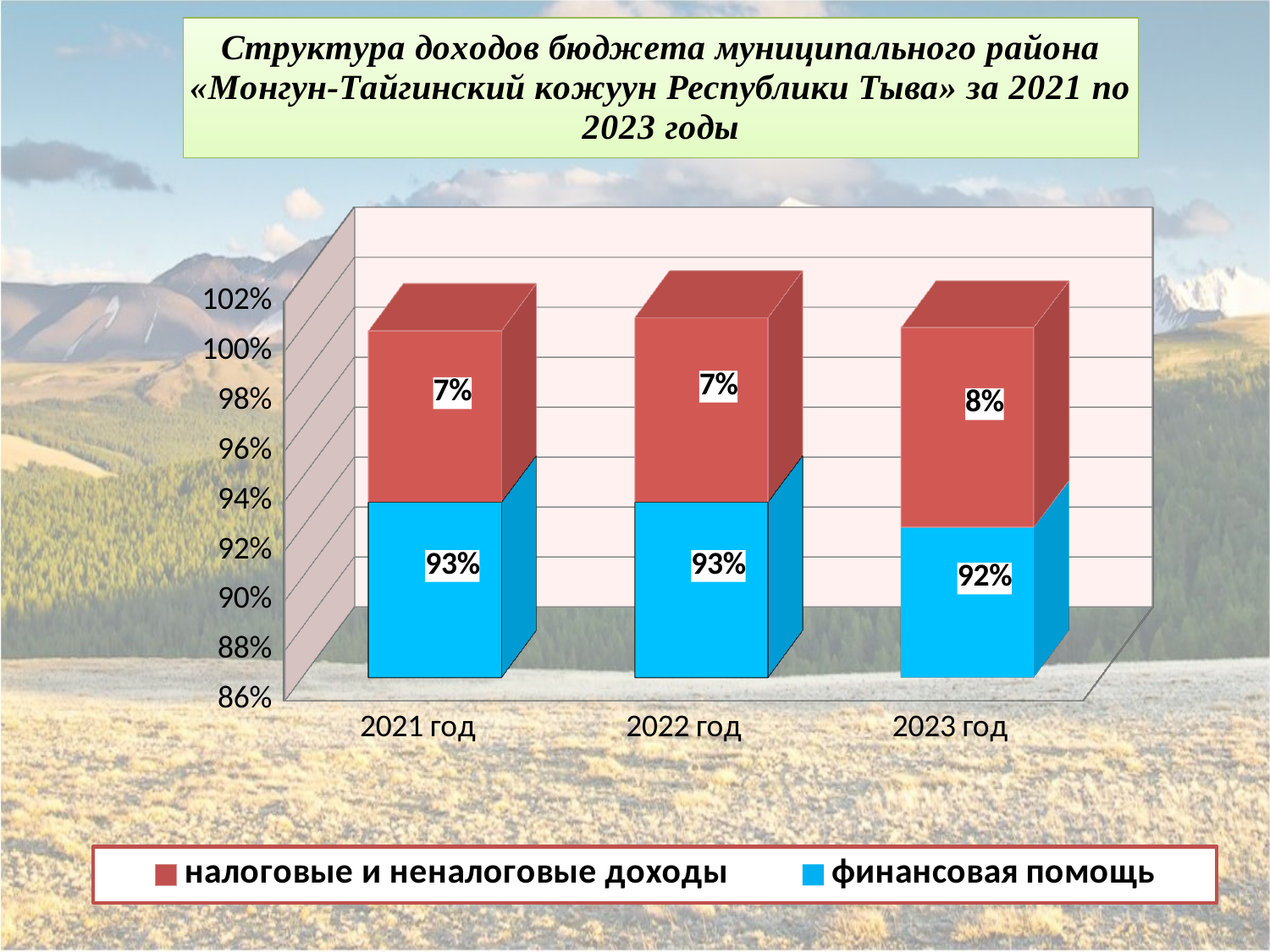
What is the value of налоговые и неналоговые доходы for 2023 год? 8% In which year is the share of финансовая помощь lowest? 2023 год What is the value of налоговые и неналоговые доходы for 2022 год? 7% What is the value of финансовая помощь for 2023 год? 92% In which year is the share of налоговые и неналоговые доходы highest? 2023 год What is the value of финансовая помощь for 2021 год? 93% What kind of chart is shown on the slide? stacked bar chart Which is larger for 2022 год: налоговые и неналоговые доходы or финансовая помощь? финансовая помощь What is the difference between the финансовая помощь value for 2021 год and for 2023 год? 1% How many series does the legend list? 2 How many years are shown on the x axis? 3 What colour represents финансовая помощь in the chart? blue